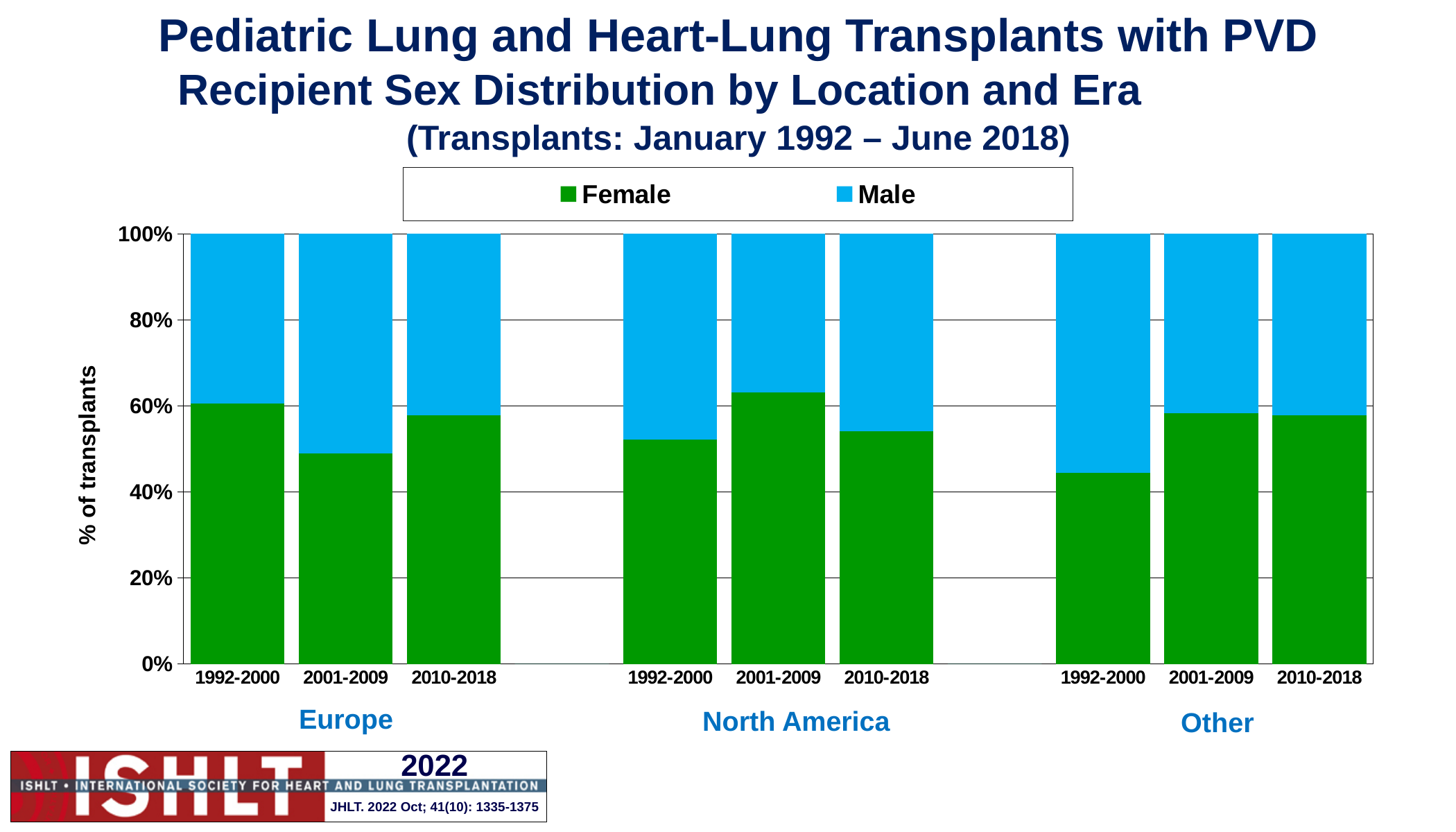
What kind of chart is shown on the slide? Stacked bar chart How many location groups are shown along the x axis? 3 Within Europe, which era has the larger Female share: 1992-2000 or 2001-2009? 1992-2000 Is the Female share for Other 1992-2000 greater or less than 60%? less Is the Female share for Europe 1992-2000 greater or less than 40%? greater How many bars are plotted in the chart? 9 Which bar has the highest Female share? North America 2001-2009 Is the Female share for Europe 2001-2009 greater or less than 60%? less How many series does the legend list? 2 Which bar has the lowest Female share? Other 1992-2000 What is the total of each stacked bar? 100% Which colour represents Male in the chart? Blue